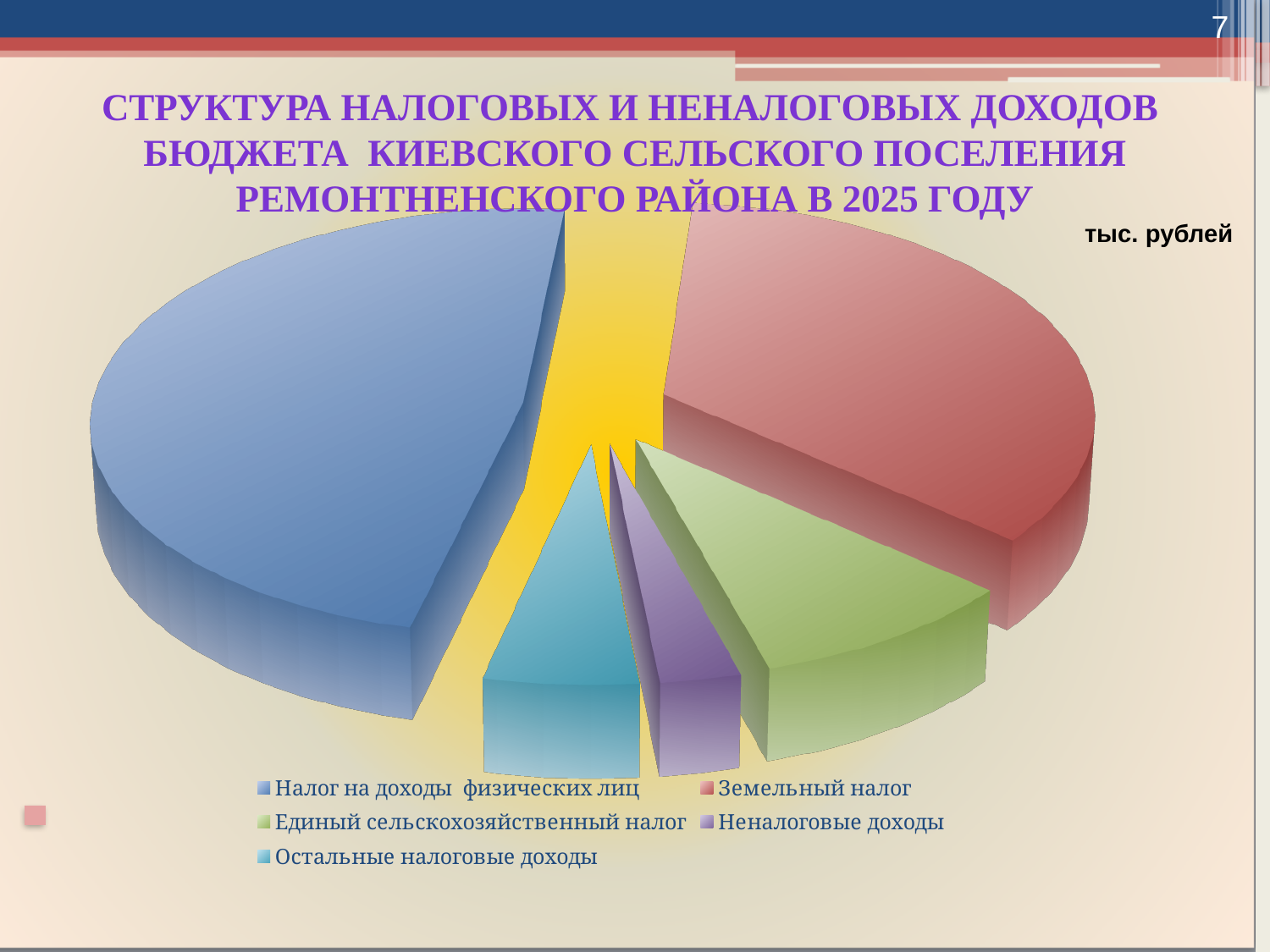
Which category has the largest slice of the pie chart? Налог на доходы физических лиц What kind of chart is shown on the slide? Pie chart Which slice is larger: Налог на доходы физических лиц or Земельный налог? Налог на доходы физических лиц Which colour represents Земельный налог in the pie chart? Red How many slices does the pie chart have? 5 In what units are the values of the pie chart expressed, according to the label on the slide? тыс. рублей How many entries does the legend of the pie chart list? 5 Which slice is larger: Земельный налог or Единый сельскохозяйственный налог? Земельный налог Which category has the smallest slice of the pie chart? Неналоговые доходы Which slice is larger: Единый сельскохозяйственный налог or Неналоговые доходы? Единый сельскохозяйственный налог